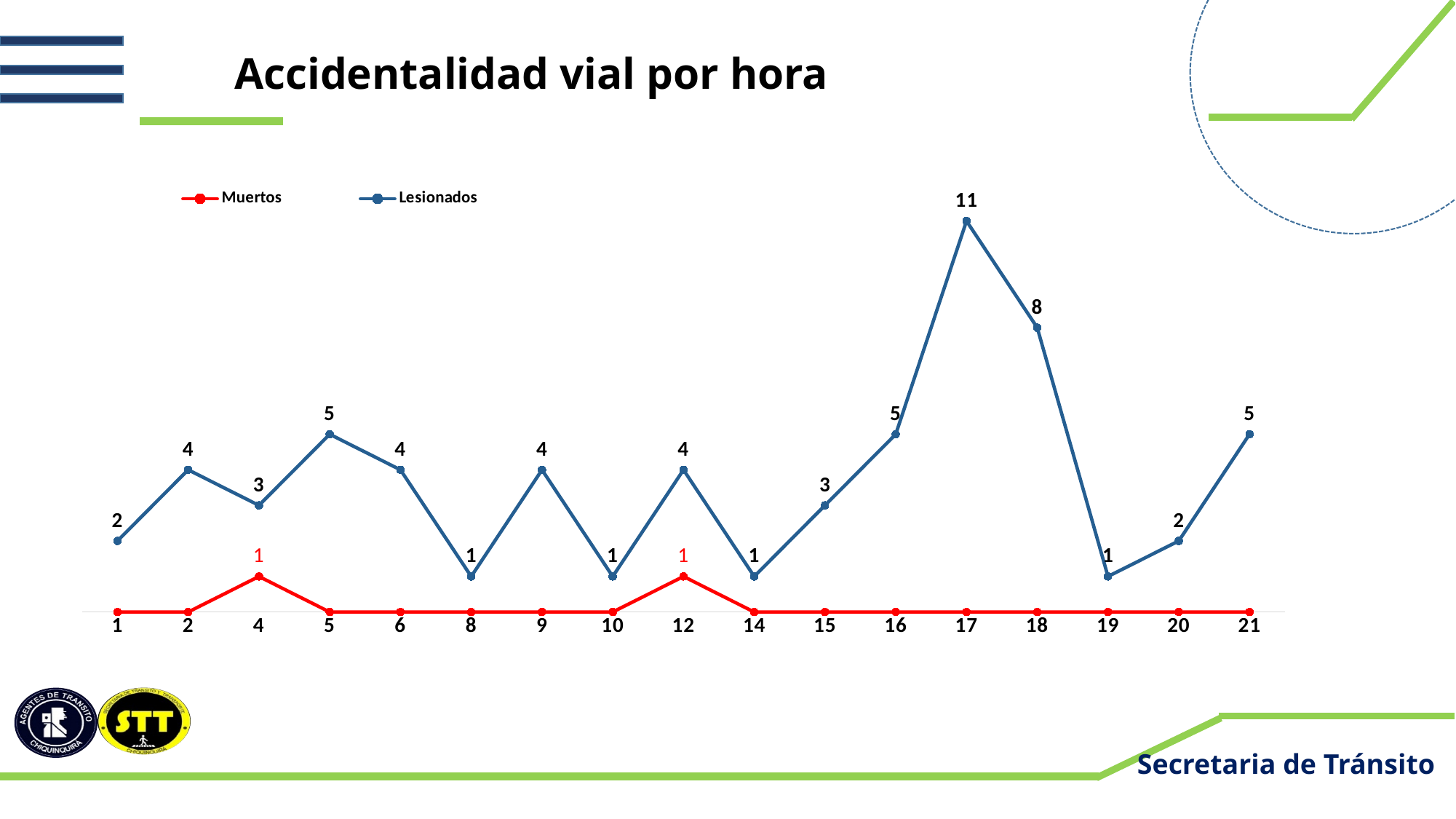
At which hour is the Lesionados value highest? 17 Which is larger, the Lesionados value at hour 5 or at hour 15? hour 5 What is the Lesionados value at hour 1? 2 What is the title of the chart? Accidentalidad vial por hora What type of chart is shown on the slide? line chart What is the Muertos value at hour 4? 1 What is the Lesionados value at hour 17? 11 Does the Lesionados line rise or fall from hour 18 to hour 19? fall How many series does the legend list? 2 What is the Lesionados value at hour 18? 8 How many hour categories are shown on the x axis? 17 What is the difference between the Lesionados values at hour 17 and hour 18? 3